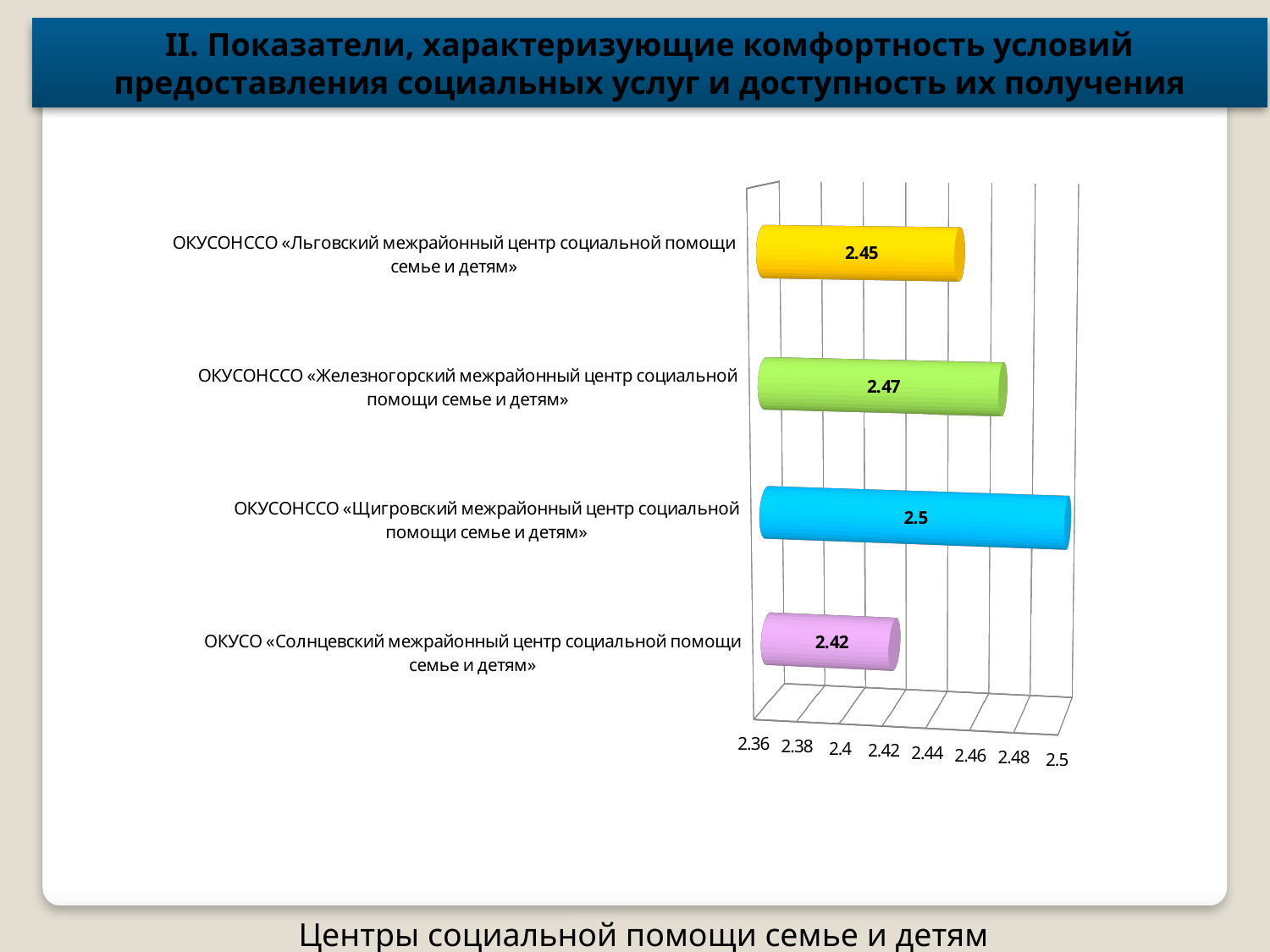
Which centre has the highest value on the chart? ОКУСОНССО «Щигровский межрайонный центр социальной помощи семье и детям» Which has a larger value, the Льговский centre or the Железногорский centre? ОКУСОНССО «Железногорский межрайонный центр социальной помощи семье и детям» What is the value for ОКУСОНССО «Льговский межрайонный центр социальной помощи семье и детям»? 2.45 What is the value for ОКУСОНССО «Железногорский межрайонный центр социальной помощи семье и детям»? 2.47 What is the value for ОКУСОНССО «Щигровский межрайонный центр социальной помощи семье и детям»? 2.5 What kind of chart is shown on the slide? Bar chart How many centres are shown on the chart? 4 Which centre has the lowest value on the chart? ОКУСО «Солнцевский межрайонный центр социальной помощи семье и детям» What is the difference between the values for the Щигровский centre and the Солнцевский centre? 0.08 What is the difference between the values for the Железногорский centre and the Льговский centre? 0.02 What is the caption shown below the chart? Центры социальной помощи семье и детям What is the value for ОКУСО «Солнцевский межрайонный центр социальной помощи семье и детям»? 2.42